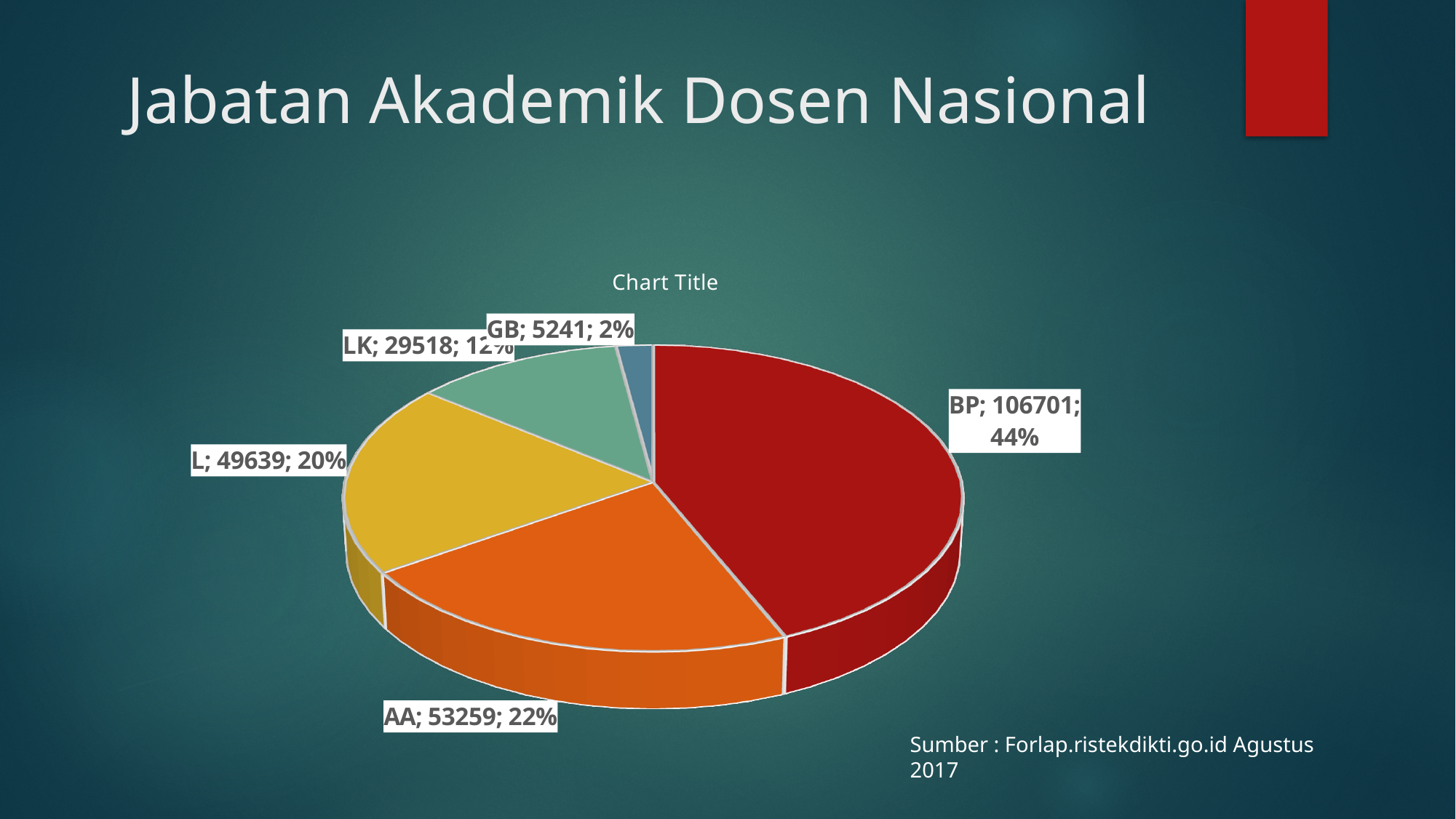
Which category has the largest slice of the pie chart? BP What is the value for BP in the pie chart? 106701 What is the value for L in the pie chart? 49639 Which category has the smallest slice of the pie chart? GB What kind of chart is shown on the slide? pie chart What share of the pie does AA represent? 22% What is the difference between the values for BP and AA? 53442 What is the value for AA in the pie chart? 53259 What share of the pie does BP represent? 44% What is the value for GB in the pie chart? 5241 How many slices does the pie chart have? 5 What is the value for LK in the pie chart? 29518